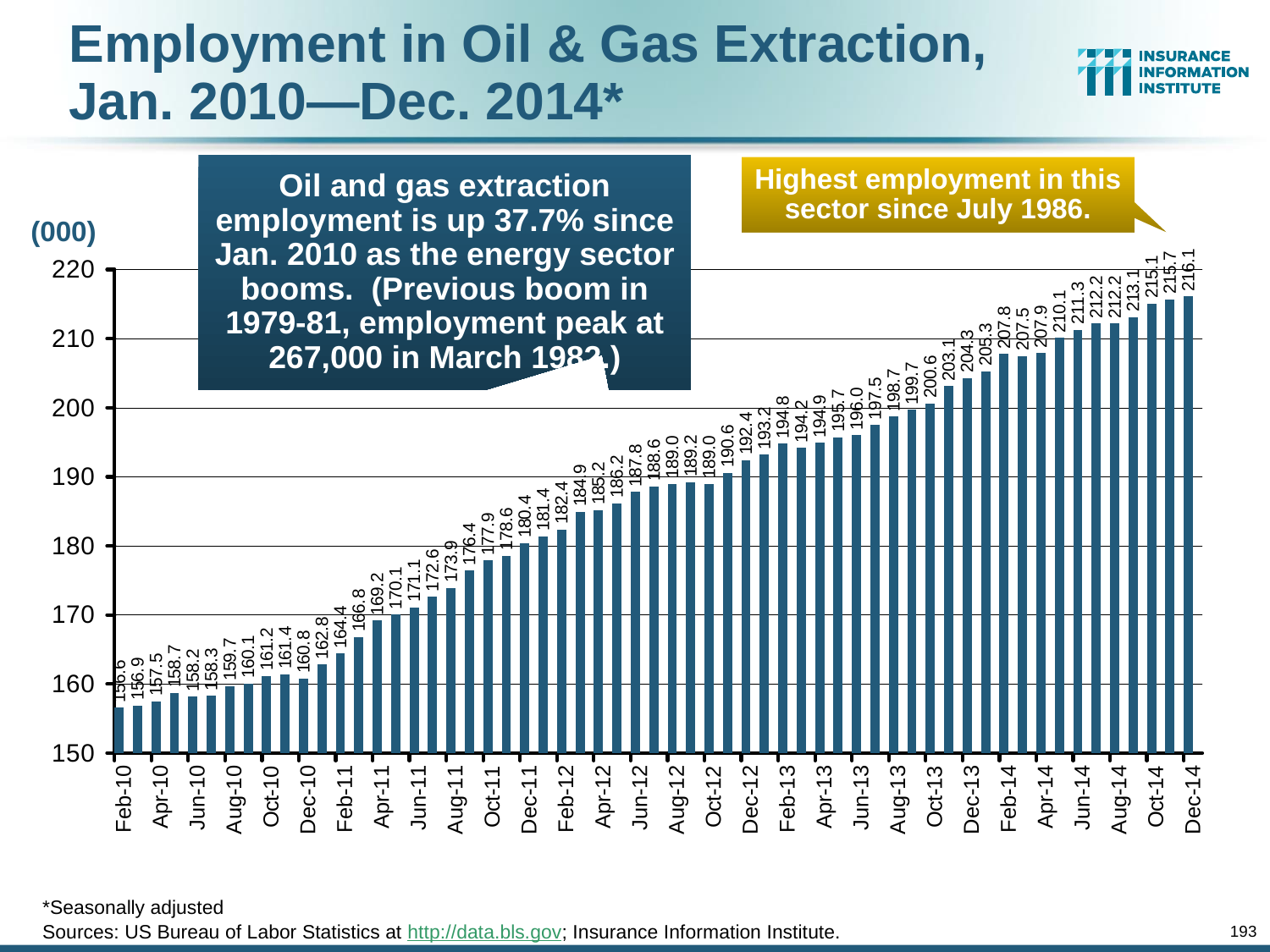
What kind of chart is shown on the slide? bar chart Which is larger, the value for Dec-14 or the value for Dec-12? Dec-14 What is the difference between the Dec-14 value and the Oct-14 value? 1.0 What is the employment value for Oct-13? 200.6 Do the values generally rise or fall from Feb-10 to Dec-14? rise Which month has the highest employment value on the chart? Dec-14 What is the employment value for Dec-14? 216.1 What is the employment value for Oct-14? 215.1 What unit is indicated for the y-axis values? (000) Which month has the lowest employment value on the chart? Feb-10 Is the value for Dec-14 greater or less than 210? greater What is the employment value for Dec-12? 192.4